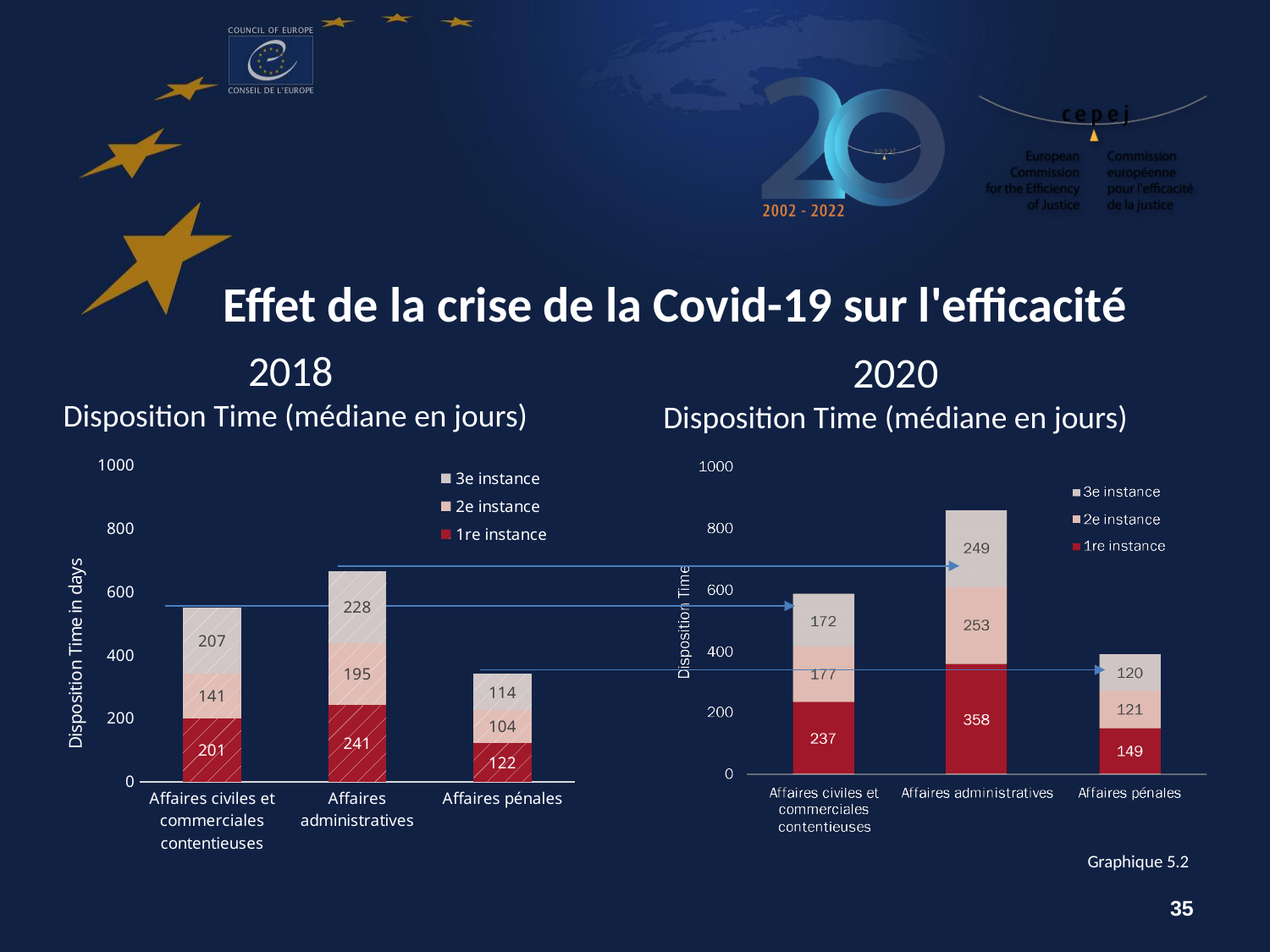
In the 2018 chart, what is the 1re instance value for Affaires administratives? 241 In the 2020 chart, what is the 3e instance value for Affaires administratives? 249 In the 2018 chart, what is the total of the stacked bar for Affaires administratives? 664 What is the difference between the 1re instance value for Affaires administratives in the 2020 chart and in the 2018 chart? 117 In the 2020 chart, which category has the tallest stacked bar? Affaires administratives In the 2020 chart, what is the total of the stacked bar for Affaires pénales? 390 What type of chart is the 2018 chart? Stacked bar chart In the 2020 chart, what is the 1re instance value for Affaires civiles et commerciales contentieuses? 237 In the 2018 chart, what is the 2e instance value for Affaires pénales? 104 Is the 3e instance value for Affaires civiles et commerciales contentieuses larger in the 2018 chart or the 2020 chart? 2018 In the 2018 chart, which category has the shortest stacked bar? Affaires pénales How many series does the legend of the 2020 chart list? 3